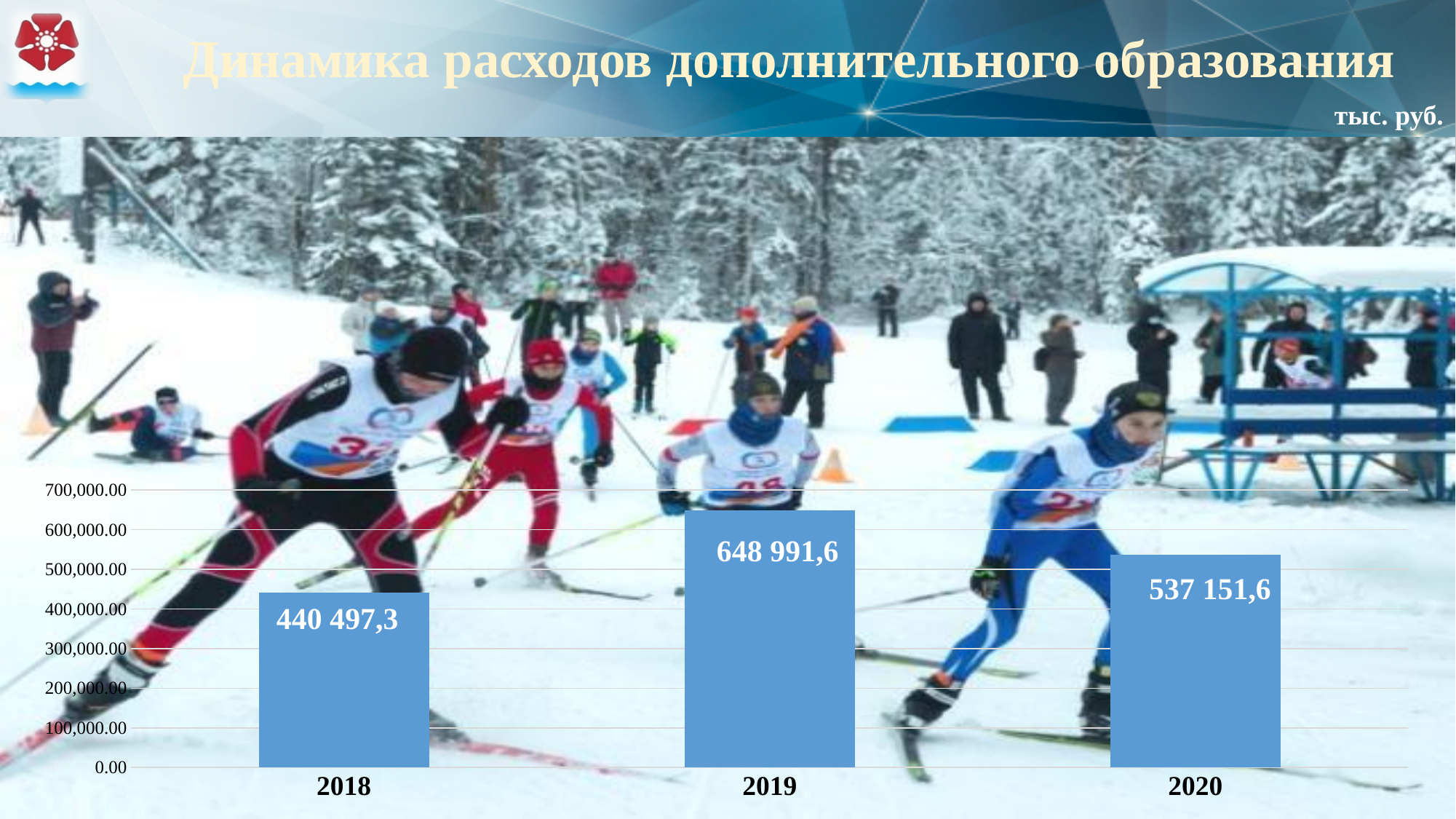
Which year has the highest value? 2019 Which year has the lowest value? 2018 Which is larger, the value for 2020 or the value for 2018? 2020 What is the difference between the values for 2019 and 2018? 208 494,3 What is the difference between the values for 2019 and 2020? 111 840,0 What unit of measurement is indicated for the chart? тыс. руб. What kind of chart is shown on the slide? bar chart What is the value for 2020? 537 151,6 How many years are shown on the chart? 3 What is the value for 2019? 648 991,6 What is the value for 2018? 440 497,3 Is the value for 2018 greater or less than 500,000.00? less